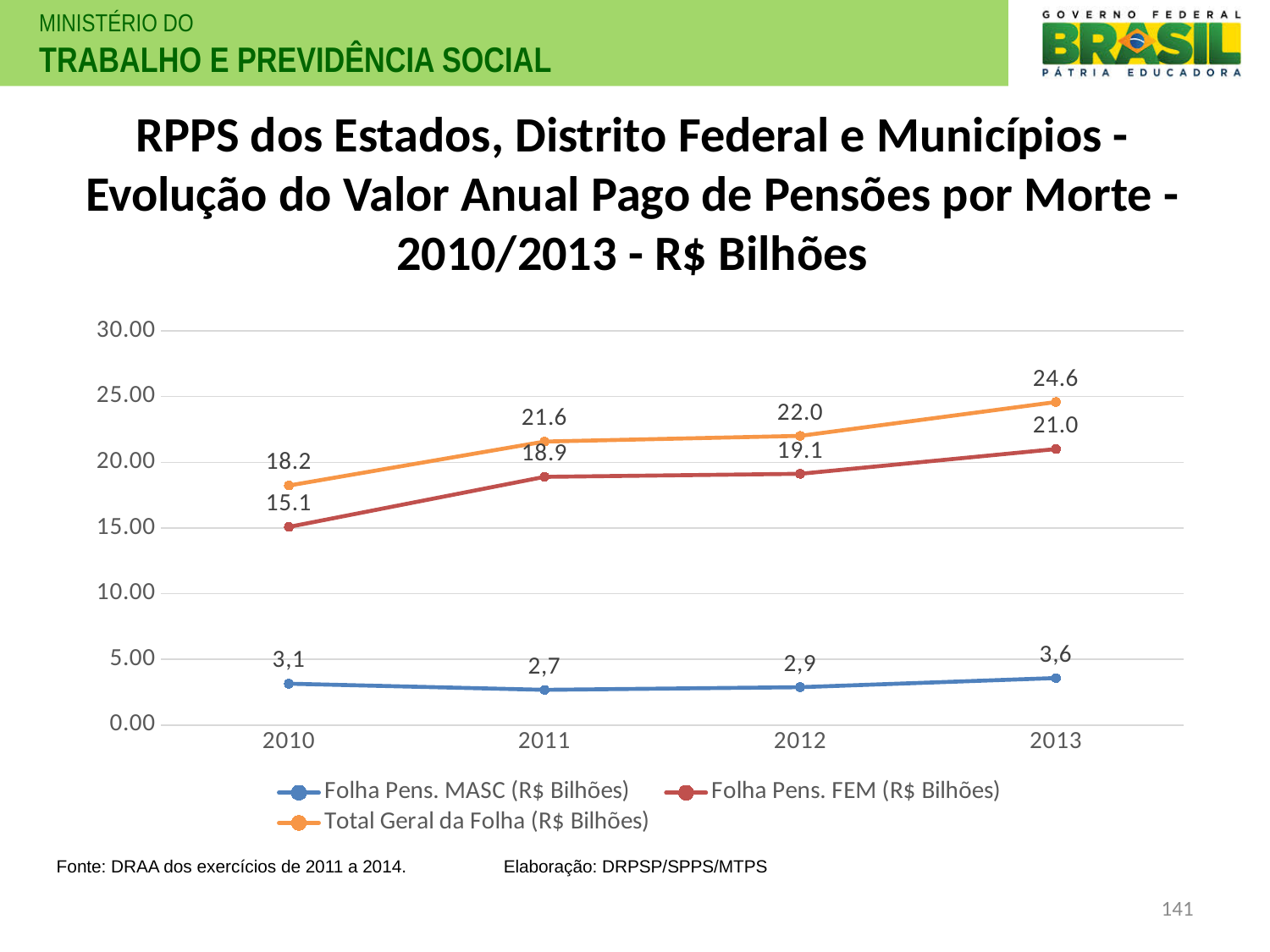
By how much did Total Geral da Folha (R$ Bilhões) increase from 2010 to 2013? 6.4 What is the value of Folha Pens. FEM (R$ Bilhões) in 2010? 15.1 Does Folha Pens. FEM (R$ Bilhões) rise or fall from 2010 to 2013? rise In which year is Folha Pens. MASC (R$ Bilhões) at its lowest? 2011 In which year is Total Geral da Folha (R$ Bilhões) at its highest? 2013 What is the difference between Total Geral da Folha and Folha Pens. FEM in 2012? 2.9 How many years are plotted along the x axis? 4 What is the value of Total Geral da Folha (R$ Bilhões) in 2013? 24.6 What type of chart is shown on the slide? line chart Is the value of Folha Pens. FEM (R$ Bilhões) in 2013 greater or less than 20.00? greater How many series does the legend list? 3 What is the value of Folha Pens. MASC (R$ Bilhões) in 2011? 2,7